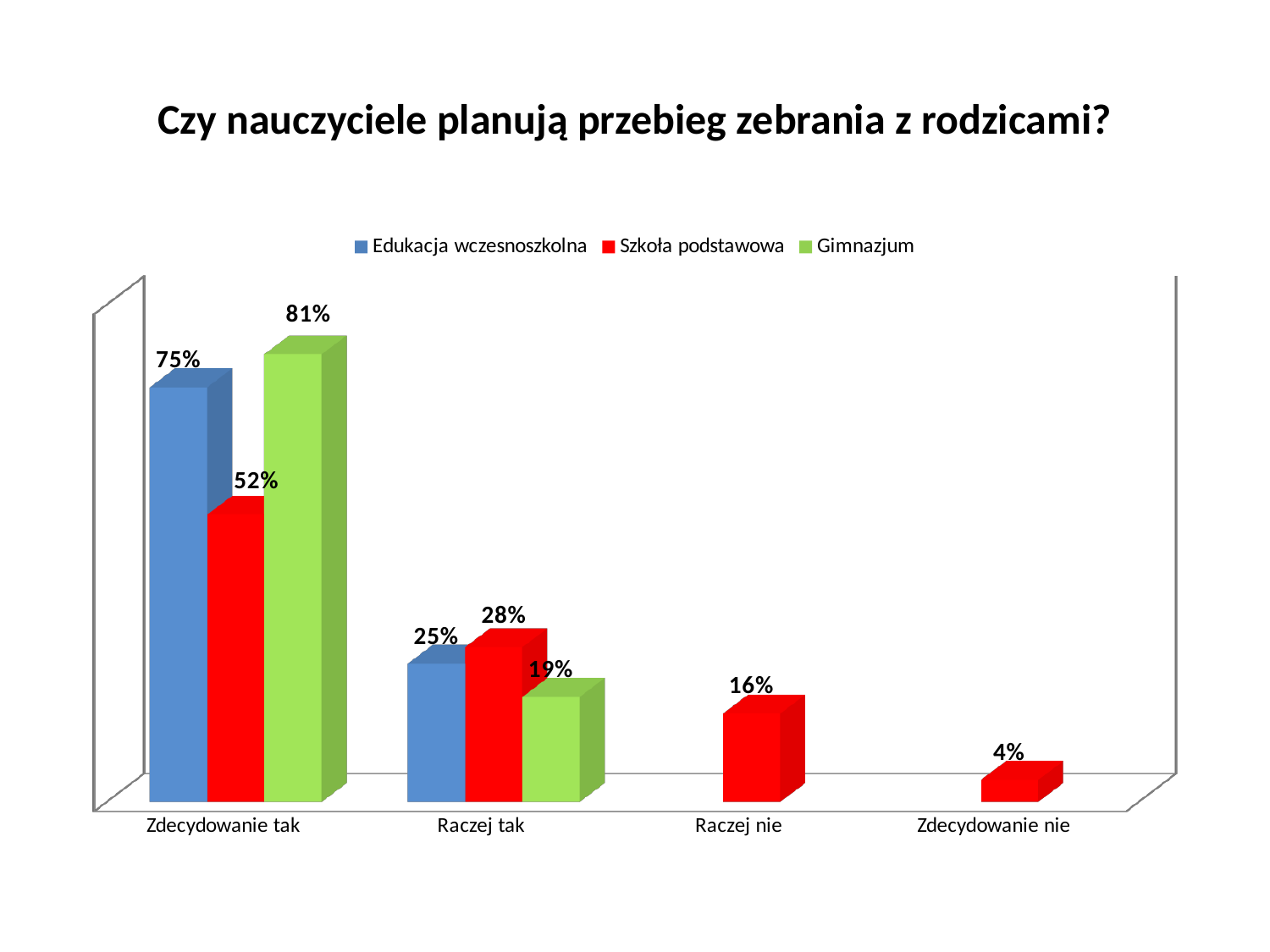
What is the title of the chart? Czy nauczyciele planują przebieg zebrania z rodzicami? What is the value for Edukacja wczesnoszkolna in the Raczej tak category? 25% How many series does the legend list? 3 What is the value for Gimnazjum in the Zdecydowanie tak category? 81% Which series has the highest value in the Zdecydowanie tak category? Gimnazjum What is the value for Szkoła podstawowa in the Zdecydowanie nie category? 4% Which series has the lowest value in the Raczej tak category? Gimnazjum What kind of chart is shown on the slide? Bar chart Which is larger in the Raczej tak category: Szkoła podstawowa or Edukacja wczesnoszkolna? Szkoła podstawowa How many categories are shown on the x axis? 4 What is the difference between the Edukacja wczesnoszkolna and Szkoła podstawowa values in the Zdecydowanie tak category? 23% What is the value for Szkoła podstawowa in the Raczej nie category? 16%